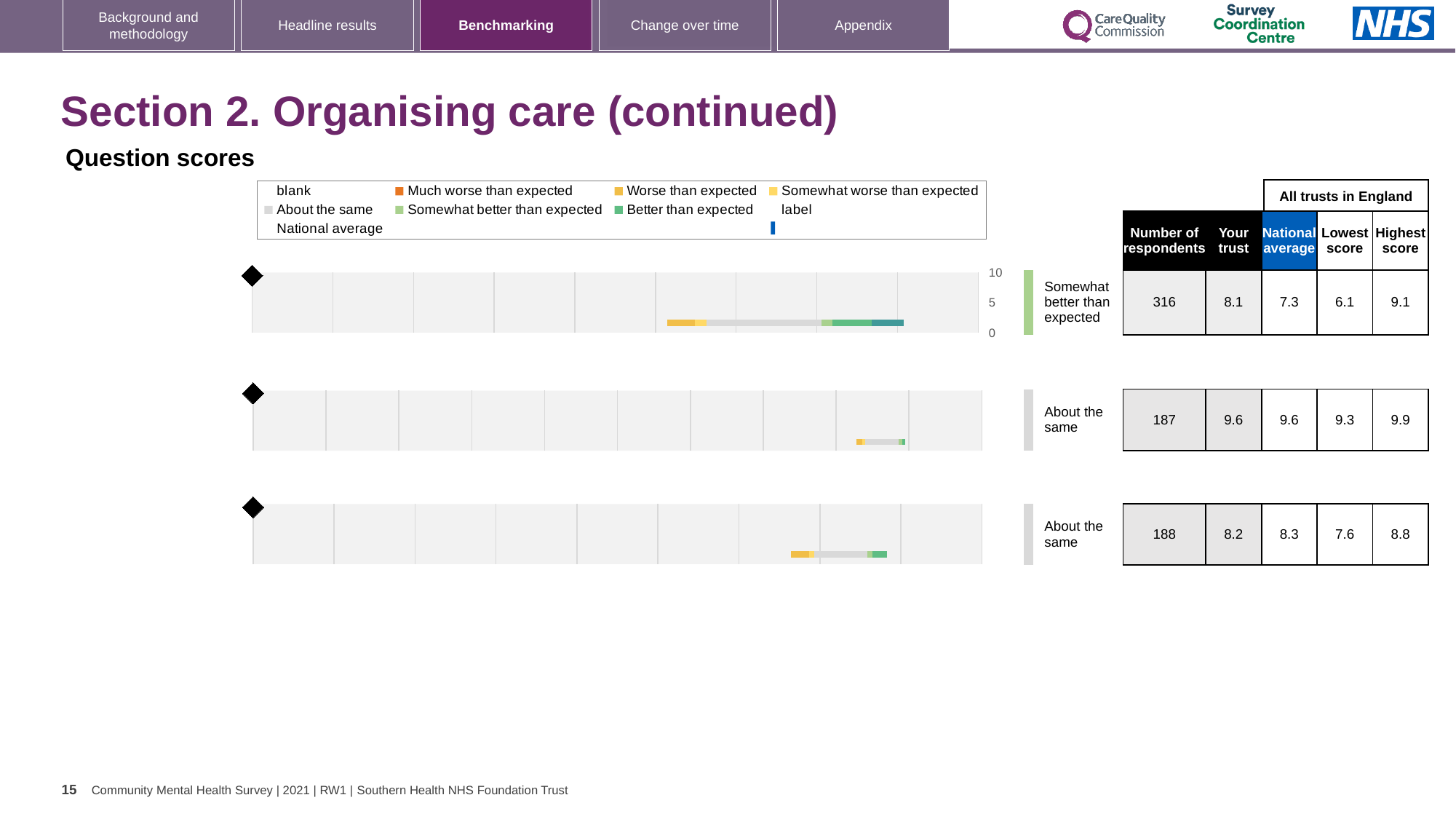
Which of the three charts has the highest 'Your trust' score? the middle chart For the bottom chart, which is larger: the 'Your trust' score or the national average? national average What kind of chart is used for the benchmarking rows on the slide? bar chart For the top chart, what is the 'Your trust' score shown in the table? 8.1 For the top chart, what is the national average score shown in the table? 7.3 For the bottom chart, what is the lowest score across all trusts in England? 7.6 For the top chart, what is the difference between the 'Your trust' score and the national average? 0.8 How many benchmarking charts are shown on the slide? 3 For the middle chart, what is the number of respondents shown in the table? 187 What is the maximum value shown on the score axis of the top chart? 10 For the middle chart, what is the highest score across all trusts in England? 9.9 What is the benchmark category label shown next to the top chart? Somewhat better than expected